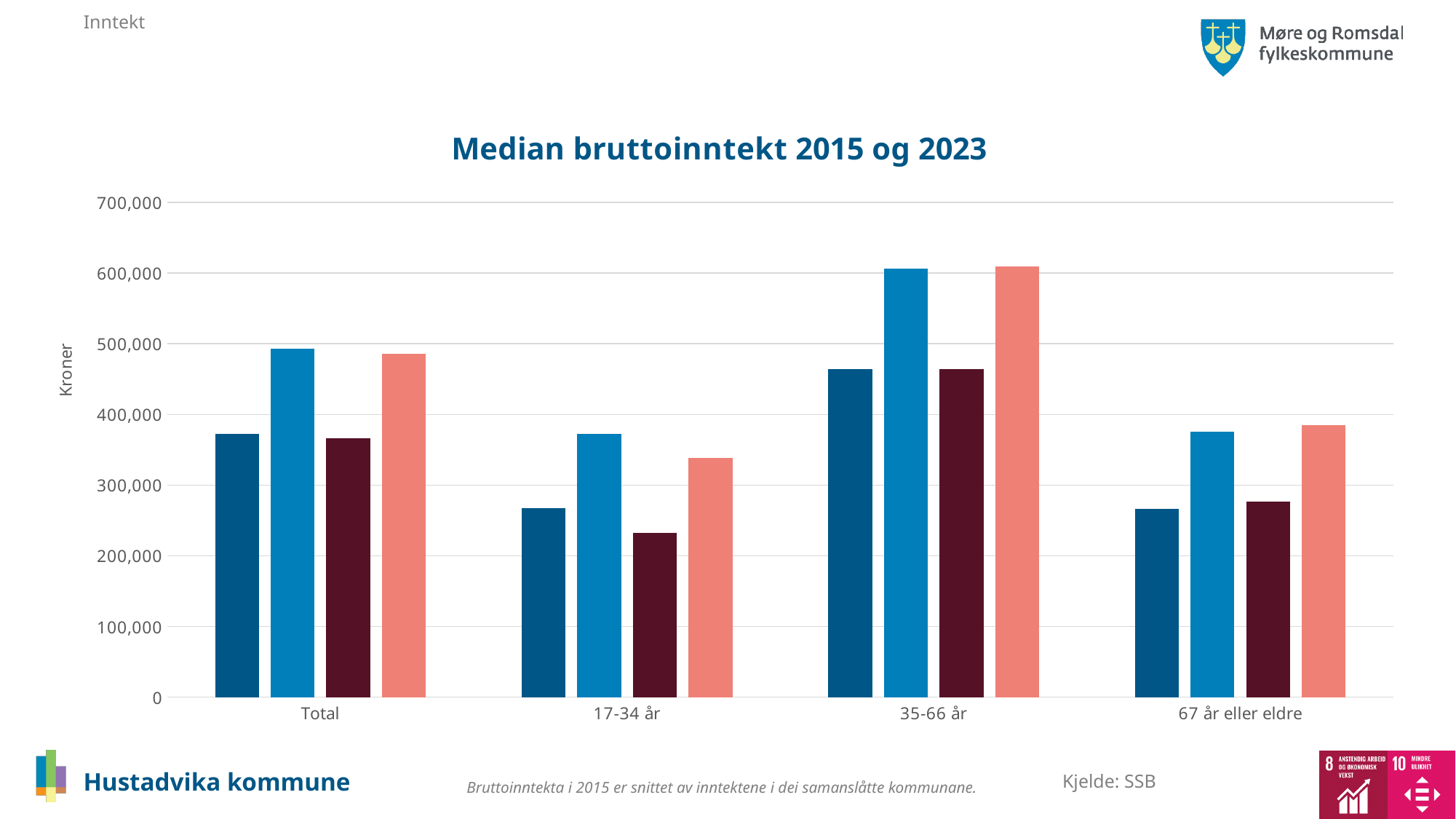
Is the value of the dark blue bar for 17-34 år greater or less than 300,000? less What kind of chart is shown on the slide? bar chart What is the title of the chart? Median bruttoinntekt 2015 og 2023 Which category has the lowest dark red bar? 17-34 år Is the value of the light blue bar for 35-66 år greater or less than 500,000? greater Which category has the highest light blue bar? 35-66 år What is the label on the vertical axis of the chart? Kroner Is the value of the dark blue bar for 35-66 år greater or less than 400,000? greater How many bars are plotted for each category in the chart? 4 How many categories are shown on the x axis of the chart? 4